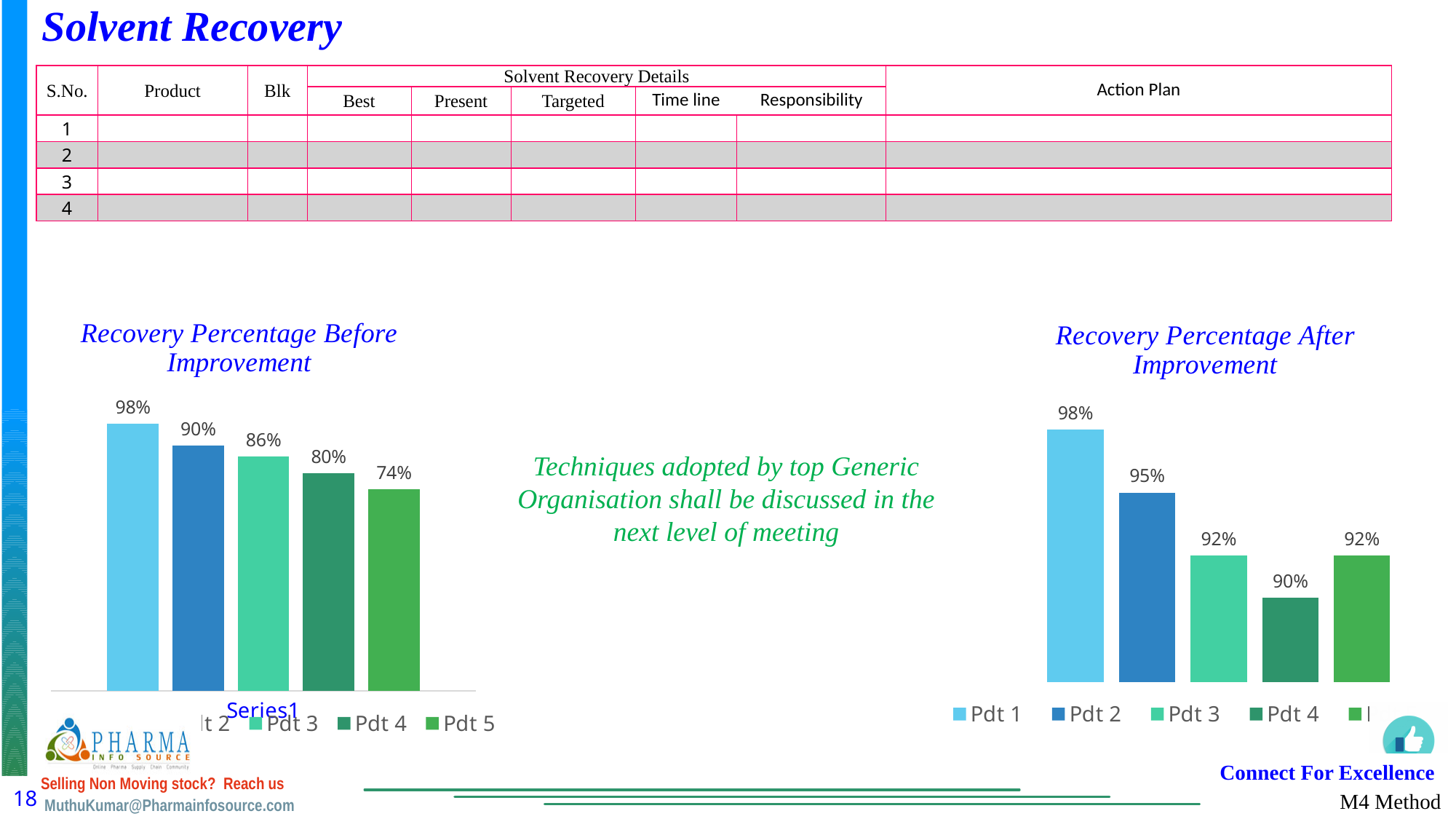
How many bars are plotted in the 'Recovery Percentage Before Improvement' chart? 5 What kind of chart is the 'Recovery Percentage After Improvement' chart? bar chart In the 'Recovery Percentage Before Improvement' chart, do the values rise or fall from left to right? fall In the 'Recovery Percentage After Improvement' chart, what is the difference between the values for Pdt 1 and Pdt 4? 8% In the 'Recovery Percentage Before Improvement' chart, what is the value for Pdt 5? 74% In the 'Recovery Percentage Before Improvement' chart, which product has the lowest recovery percentage? Pdt 5 In the 'Recovery Percentage After Improvement' chart, which product has the highest recovery percentage? Pdt 1 In the 'Recovery Percentage After Improvement' chart, what is the value for Pdt 4? 90% In the 'Recovery Percentage After Improvement' chart, which is larger, the value for Pdt 2 or the value for Pdt 3? Pdt 2 In the 'Recovery Percentage After Improvement' chart, what is the value for Pdt 2? 95% In the 'Recovery Percentage Before Improvement' chart, what is the value for Pdt 3? 86% In the 'Recovery Percentage Before Improvement' chart, what is the difference between the values for Pdt 3 and Pdt 4? 6%